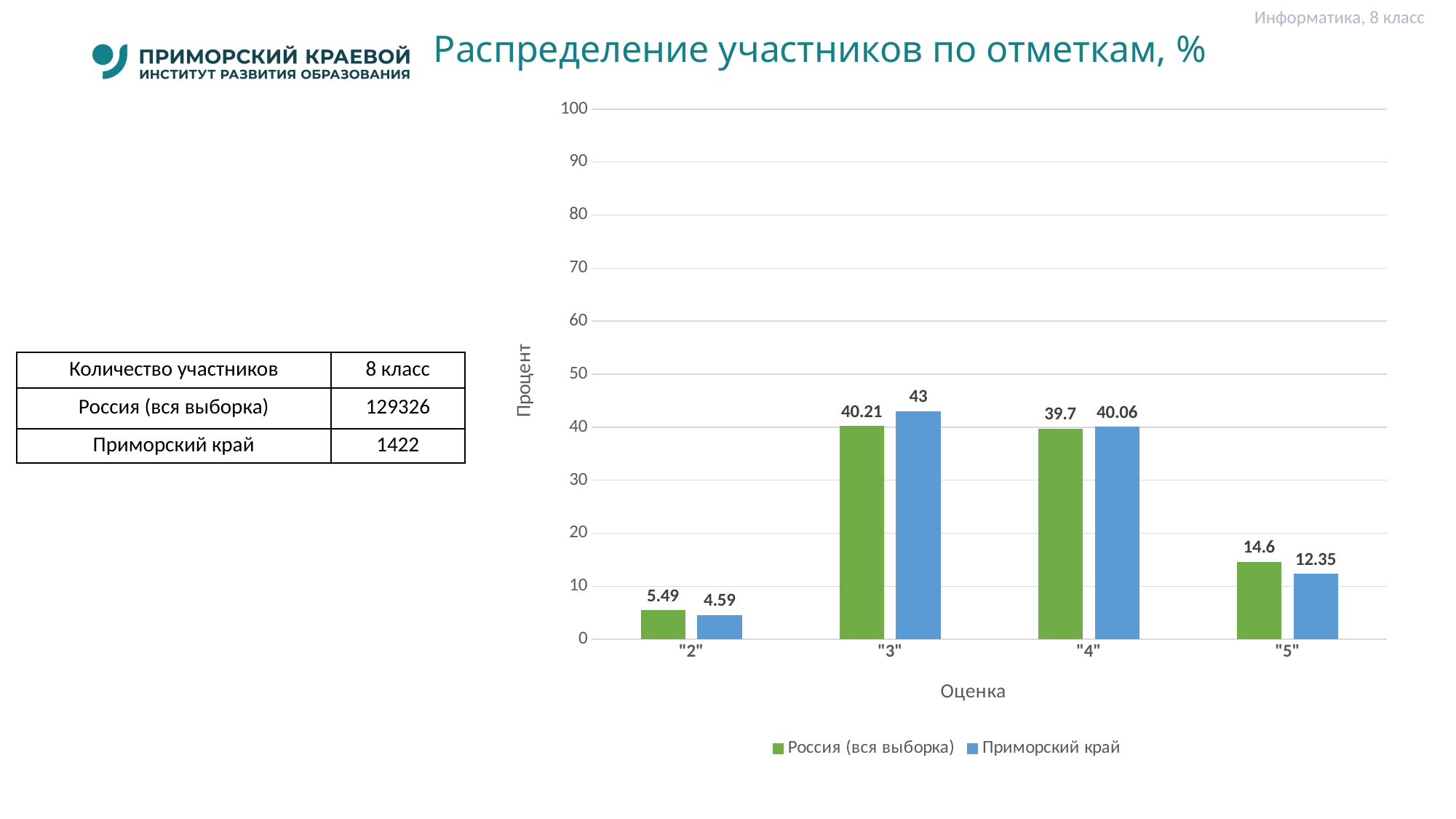
What is the difference between Приморский край and Россия (вся выборка) at mark "3"? 2.79 What is the value for Россия (вся выборка) at mark "3"? 40.21 Which mark has the highest value for Приморский край? "3" Is the value for Россия (вся выборка) at mark "5" greater or less than 10? greater What is the value for Приморский край at mark "5"? 12.35 What is the value for Приморский край at mark "2"? 4.59 What kind of chart is shown on the slide? bar chart How many mark categories are shown on the x axis? 4 What is the difference between Россия (вся выборка) and Приморский край at mark "5"? 2.25 Which mark has the lowest value for Россия (вся выборка)? "2" How many series does the legend list? 2 At mark "3", which series has the larger value: Россия (вся выборка) or Приморский край? Приморский край